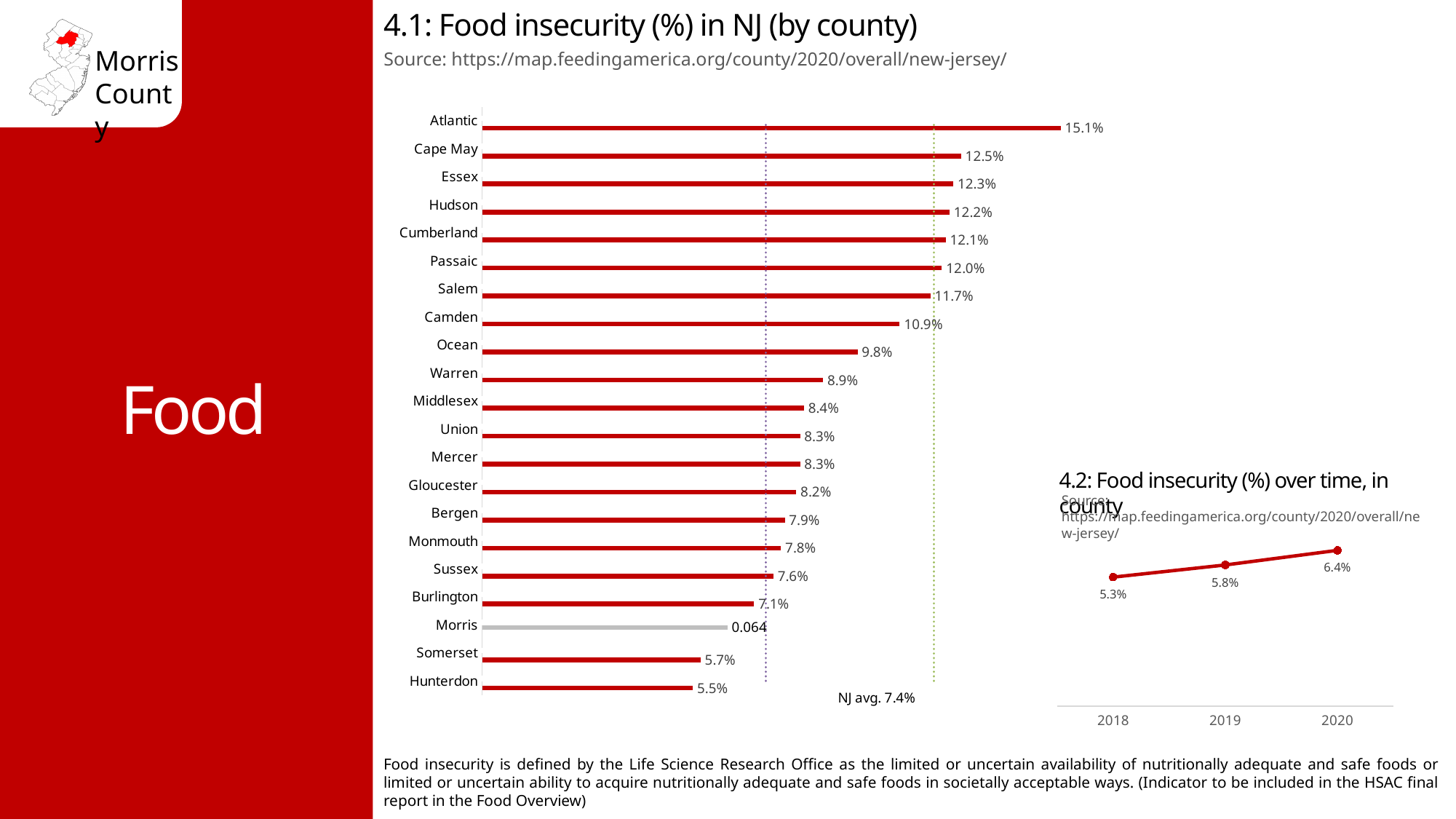
In chart 4.1, what NJ average value is noted on the chart? 7.4% In chart 4.2, do the values rise or fall from 2018 to 2020? rise What kind of chart is chart 4.2, 'Food insecurity (%) over time, in county'? line chart In chart 4.1, what is the difference between the values for Atlantic and Hunterdon? 9.6 percentage points In chart 4.2, what is the food insecurity value for 2018? 5.3% What kind of chart is chart 4.1, 'Food insecurity (%) in NJ (by county)'? bar chart How many counties are shown in chart 4.1? 21 In chart 4.1, what label is printed next to the Morris bar? 0.064 In chart 4.1, which county has the lowest food insecurity? Hunterdon In chart 4.1, which county has the highest food insecurity? Atlantic In chart 4.1, which has the larger value, Camden or Ocean? Camden In chart 4.1, what is the food insecurity value for Atlantic? 15.1%